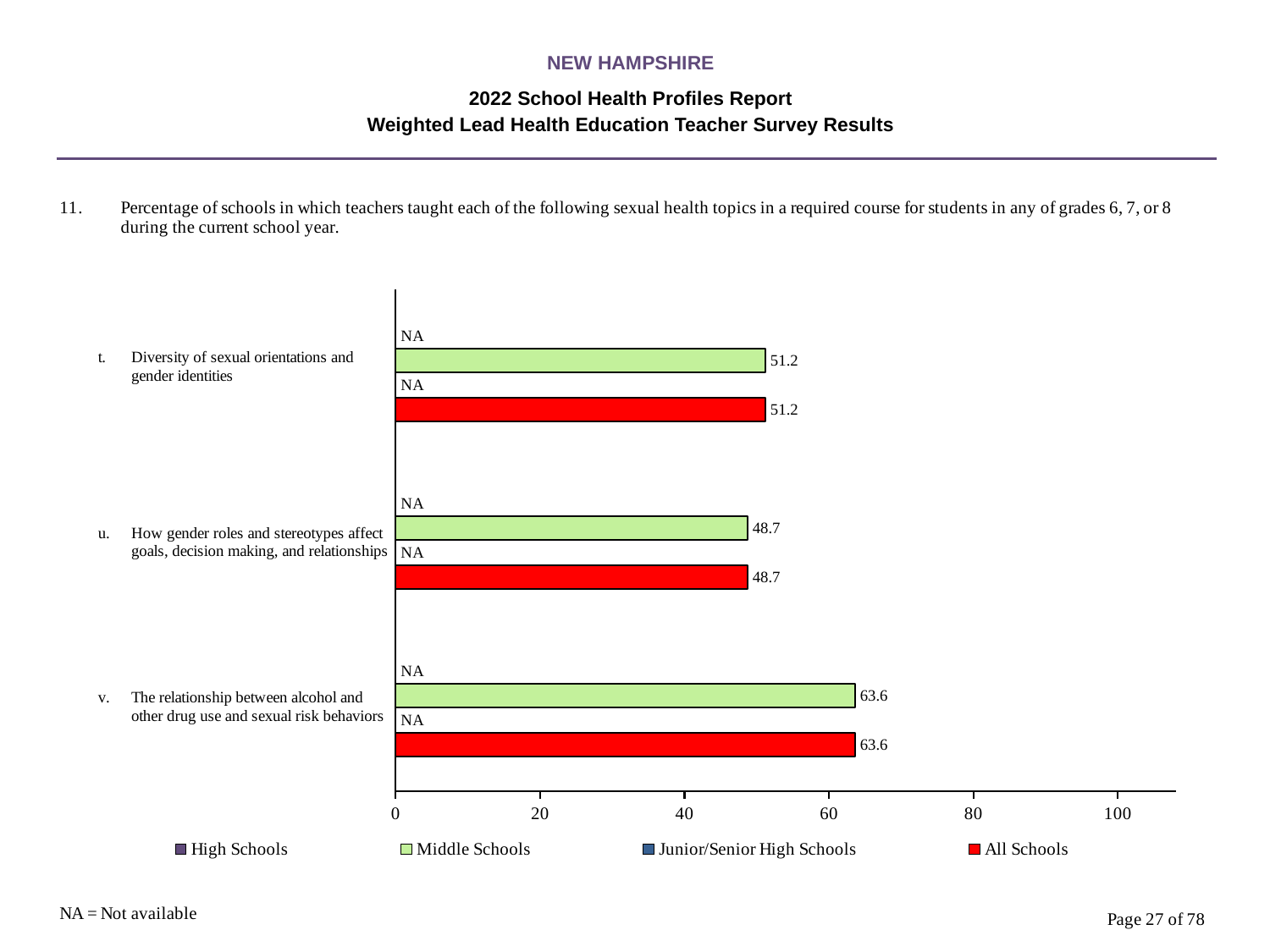
What is the Middle Schools value for 'The relationship between alcohol and other drug use and sexual risk behaviors'? 63.6 What is the All Schools value for 'How gender roles and stereotypes affect goals, decision making, and relationships'? 48.7 Which is larger for All Schools: 'Diversity of sexual orientations and gender identities' or 'How gender roles and stereotypes affect goals, decision making, and relationships'? Diversity of sexual orientations and gender identities What kind of chart is shown? bar chart How many series does the legend list? 4 What is the Middle Schools value for 'Diversity of sexual orientations and gender identities'? 51.2 What is shown for High Schools for 'Diversity of sexual orientations and gender identities'? NA Which topic has the highest Middle Schools value? The relationship between alcohol and other drug use and sexual risk behaviors What is the difference between the Middle Schools values for 'The relationship between alcohol and other drug use and sexual risk behaviors' and 'Diversity of sexual orientations and gender identities'? 12.4 How many topics are listed on the chart? 3 Which topic has the lowest All Schools value? How gender roles and stereotypes affect goals, decision making, and relationships Is the All Schools value for 'The relationship between alcohol and other drug use and sexual risk behaviors' greater or less than 60? greater